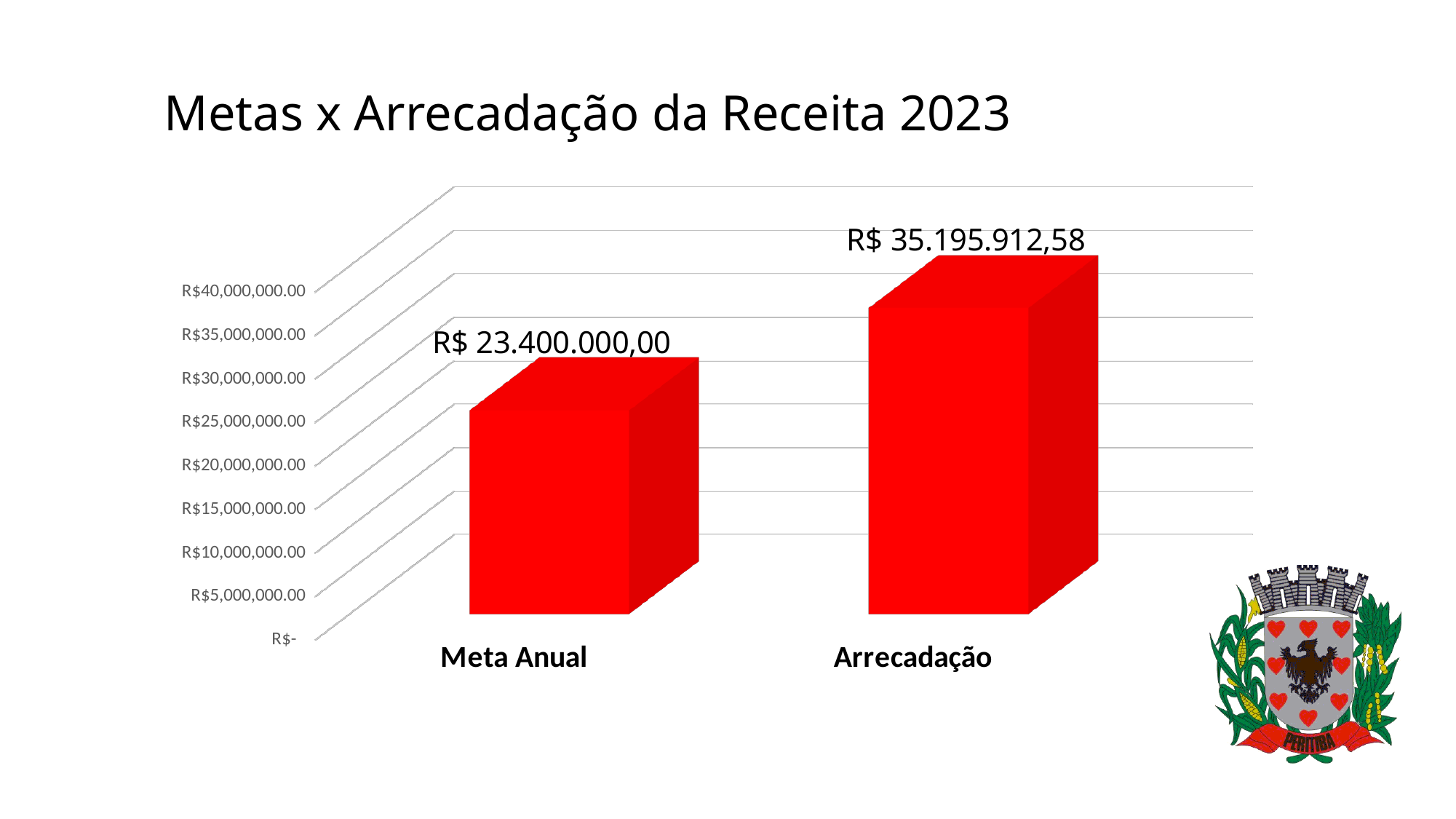
Which is larger, Meta Anual or Arrecadação? Arrecadação What is the difference between the Arrecadação value and the Meta Anual value? R$ 11.795.912,58 What is the value for Meta Anual? R$ 23.400.000,00 Which category has the highest value? Arrecadação How many categories are shown in the chart? 2 What kind of chart is shown on the slide? bar chart Do the values rise or fall from Meta Anual to Arrecadação? rise What is the title of the slide containing the chart? Metas x Arrecadação da Receita 2023 Which category has the lowest value? Meta Anual Is the value for Meta Anual greater or less than R$20,000,000.00? greater Is the value for Arrecadação greater or less than R$40,000,000.00? less What is the value for Arrecadação? R$ 35.195.912,58